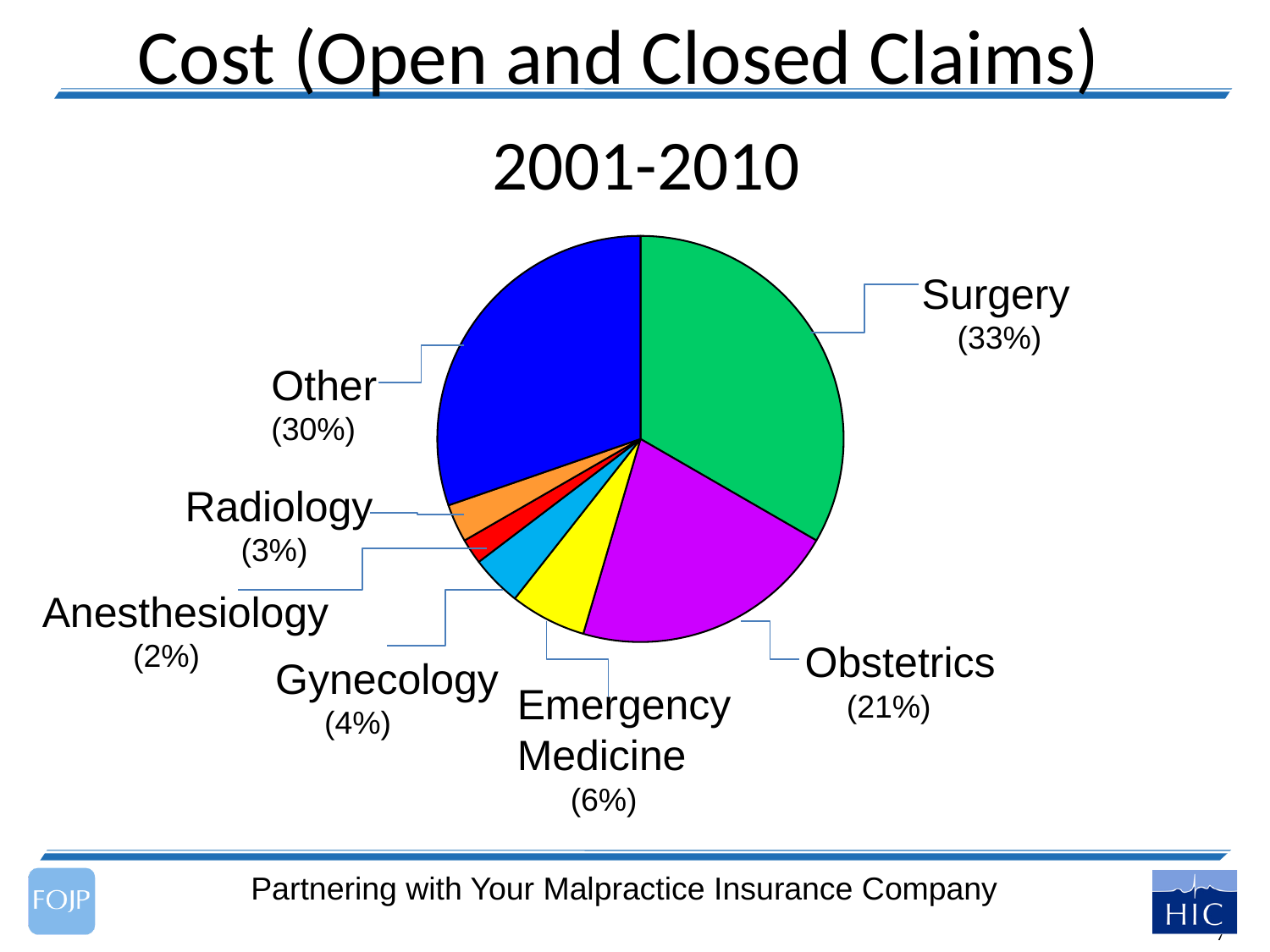
What time period does the chart cover, according to its title? 2001-2010 Which has a larger share, Gynecology or Radiology? Gynecology What share of cost does Anesthesiology account for? 2% What is the combined share of Surgery and Obstetrics? 54% Which category has the largest share of the pie? Surgery What share of cost does Emergency Medicine account for? 6% What share of cost does Obstetrics account for? 21% What kind of chart is shown on the slide? pie chart How many categories are shown in the pie chart? 7 What is the difference in percentage points between Surgery and Other? 3 Which category has the smallest share of the pie? Anesthesiology